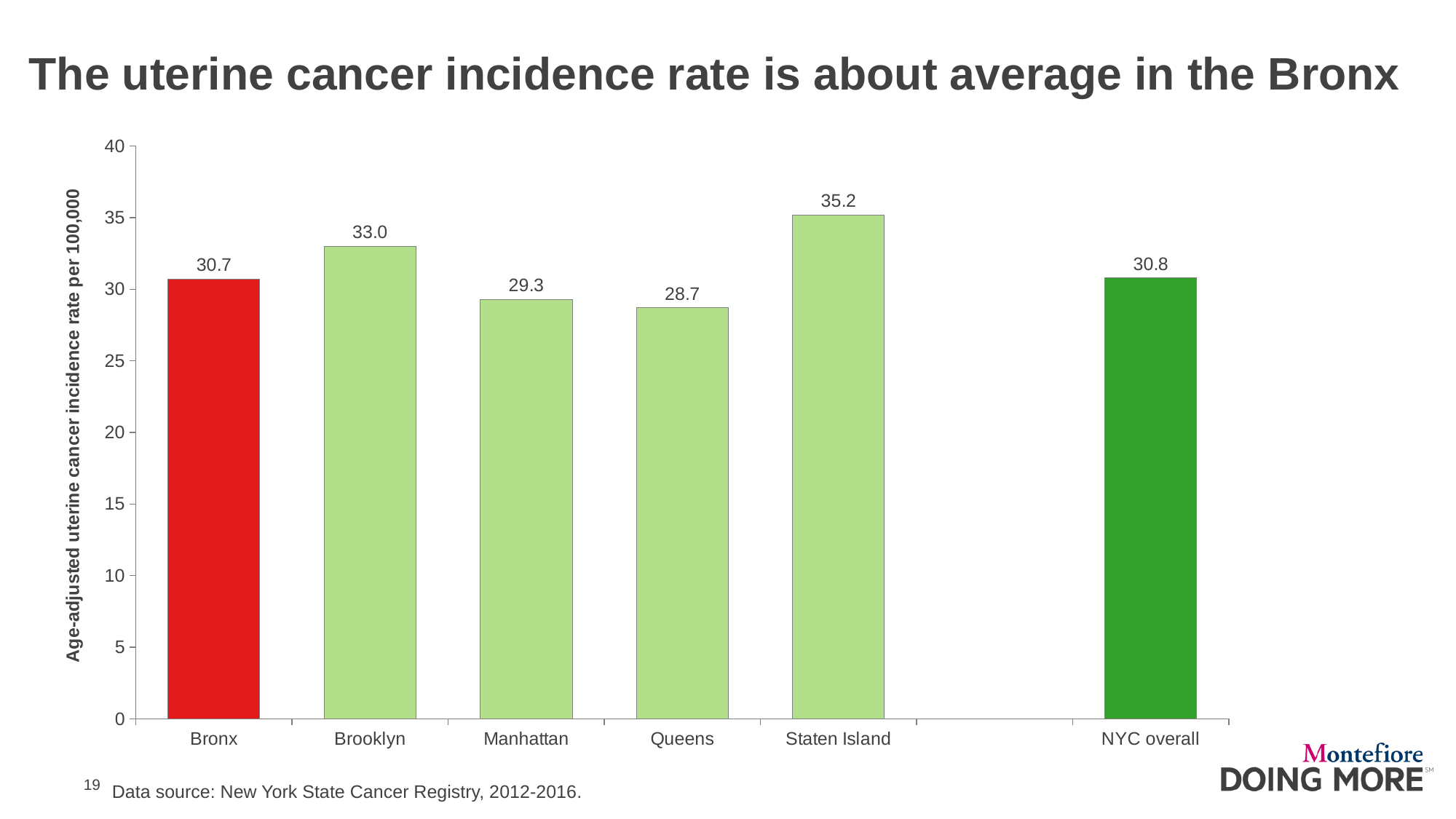
Is the uterine cancer incidence rate for Staten Island greater or less than 35? greater Which borough has the highest uterine cancer incidence rate? Staten Island What is the age-adjusted uterine cancer incidence rate per 100,000 for the Bronx? 30.7 What type of chart is shown on the slide? Bar chart How many bars are plotted in the chart? 6 What is the difference between the uterine cancer incidence rates of Brooklyn and Manhattan? 3.7 What is the difference between the uterine cancer incidence rates of Staten Island and Queens? 6.5 Which borough has the lowest uterine cancer incidence rate? Queens What is the uterine cancer incidence rate shown for NYC overall? 30.8 What is the uterine cancer incidence rate shown for Staten Island? 35.2 What colour is the bar for the Bronx? Red Which has a higher uterine cancer incidence rate, Brooklyn or Manhattan? Brooklyn